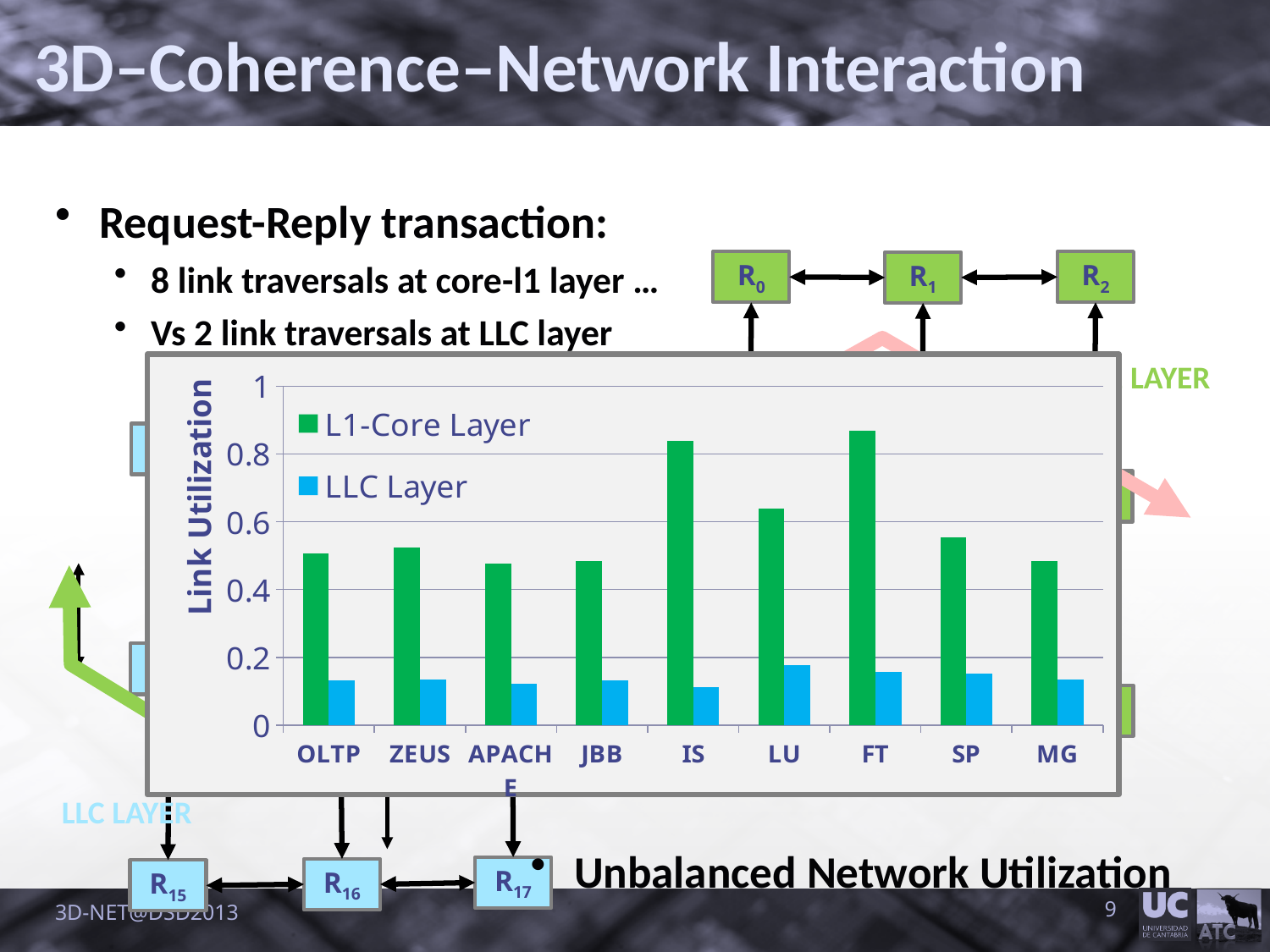
Which category has the highest L1-Core Layer link utilization? FT Is the LLC Layer value for LU greater or less than 0.2? less Is the L1-Core Layer value for SP greater or less than 0.6? less Which category has the highest LLC Layer link utilization? LU Is the L1-Core Layer value for IS greater or less than 0.8? greater What is the label of the y axis of the chart? Link Utilization How many categories are shown on the x axis of the chart? 9 What kind of chart is shown on the slide? bar chart How many series does the chart legend list? 2 Which series is shown in green in the chart? L1-Core Layer Which has the larger L1-Core Layer value, LU or MG? LU For OLTP, which series has the larger value, L1-Core Layer or LLC Layer? L1-Core Layer